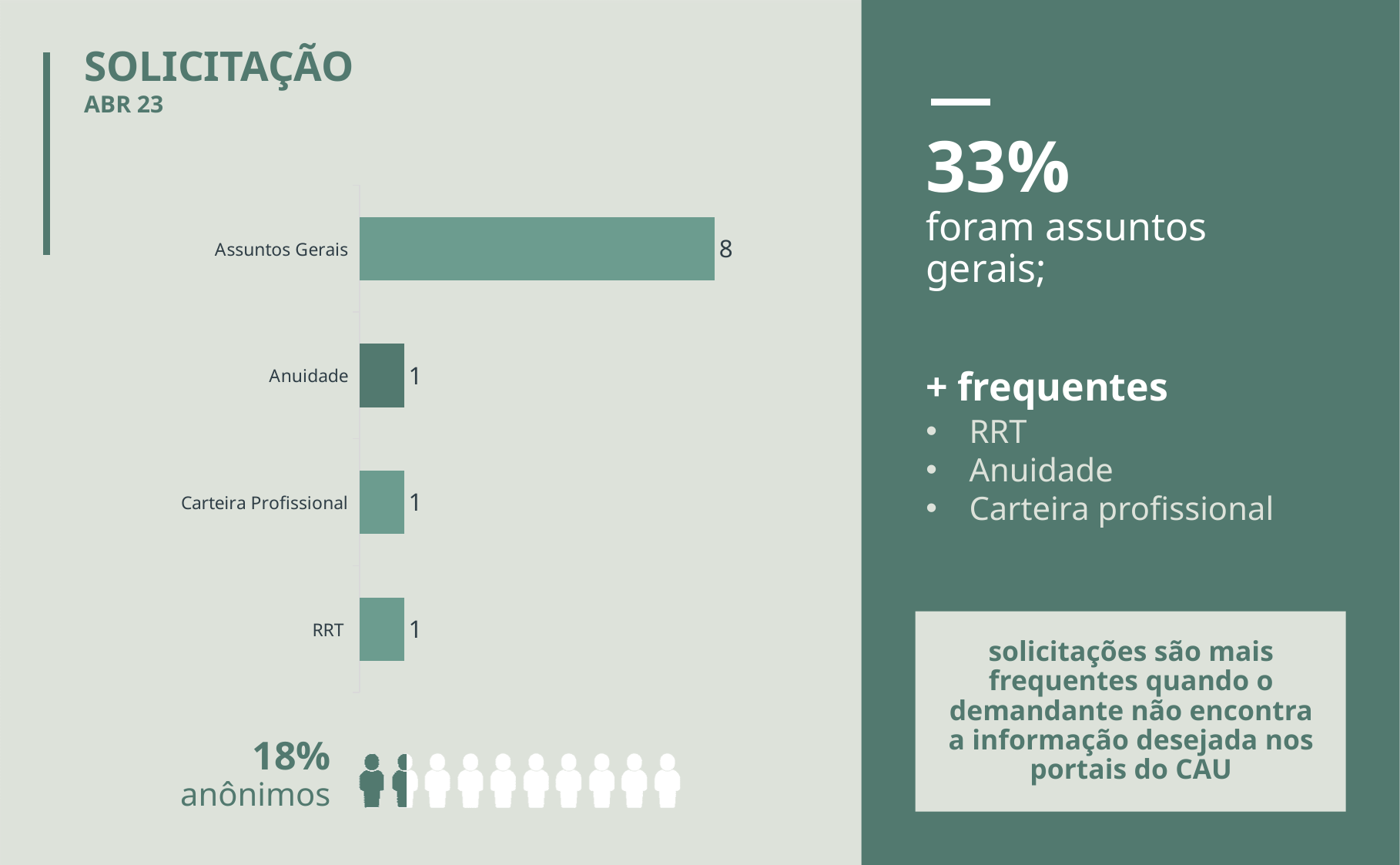
What is the title of the chart on the slide? SOLICITAÇÃO What is the value for Anuidade? 1 What is the value for RRT? 1 What is the difference between the values for Assuntos Gerais and RRT? 7 Which category's bar is drawn in a darker green than the others? Anuidade What is the value for Carteira Profissional? 1 Which category has the highest value? Assuntos Gerais What kind of chart is shown on the slide? Bar chart How many categories are shown in the chart? 4 What is the total of all the values shown in the chart? 11 What is the value for Assuntos Gerais? 8 Which is larger, the value for Assuntos Gerais or the value for Anuidade? Assuntos Gerais